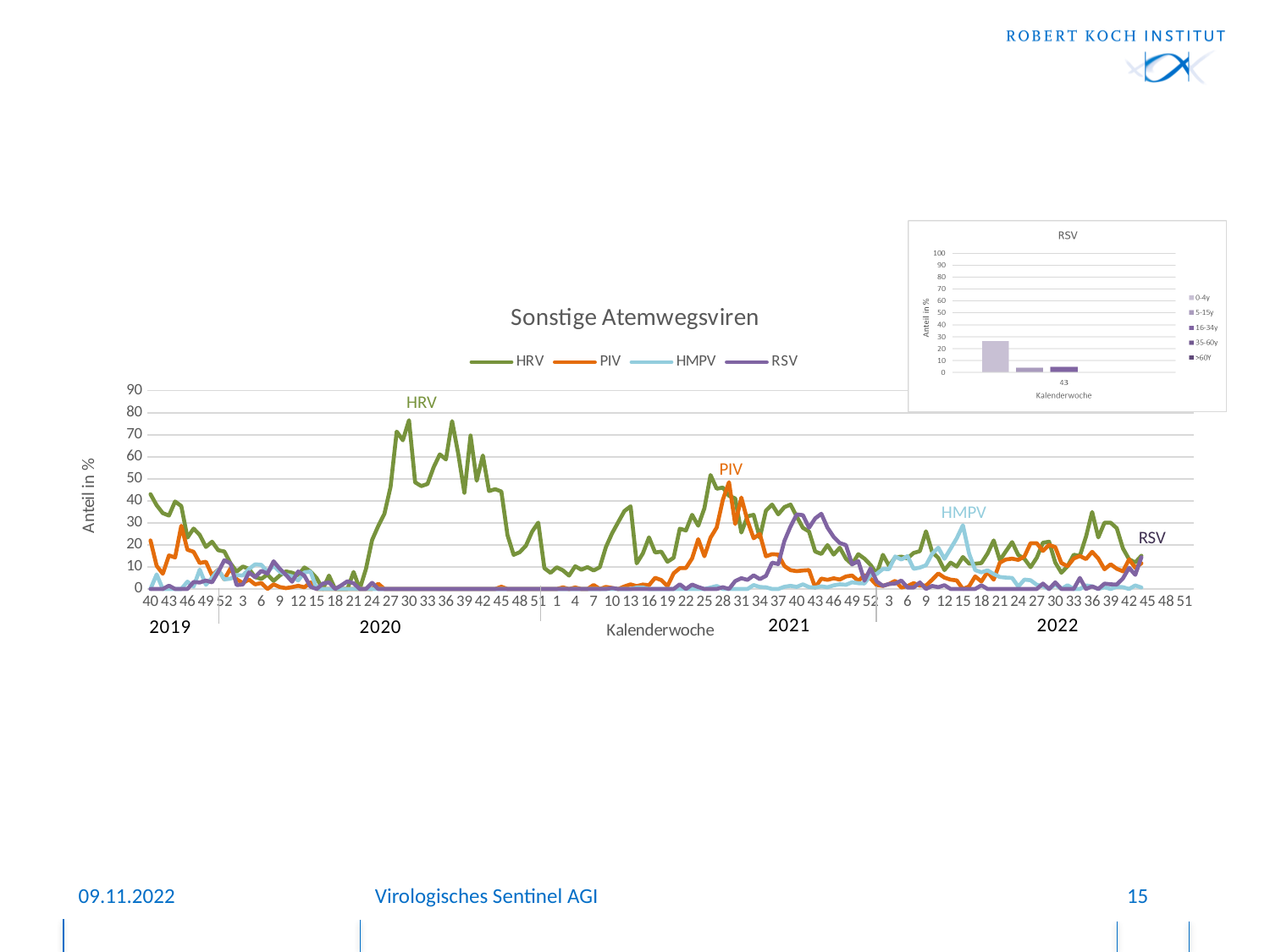
In the small 'RSV' chart, is the value for the 0-4y age group greater or less than 20? greater In the small 'RSV' chart, is the value for the 0-4y age group greater or less than 40? less In the 'Sonstige Atemwegsviren' chart, which series reaches the highest value over the whole period? HRV What is the label of the y axis of the 'Sonstige Atemwegsviren' chart? Anteil in % In the 'Sonstige Atemwegsviren' chart, is the peak value of HRV in 2020 greater or less than 70? greater How many series does the legend of the small 'RSV' chart list? 5 What kind of chart is the 'Sonstige Atemwegsviren' chart? line chart How many series does the legend of the 'Sonstige Atemwegsviren' chart list? 4 What kind of chart is the small 'RSV' chart in the top right? bar chart In the small 'RSV' chart, which age group has the highest value in Kalenderwoche 43? 0-4y